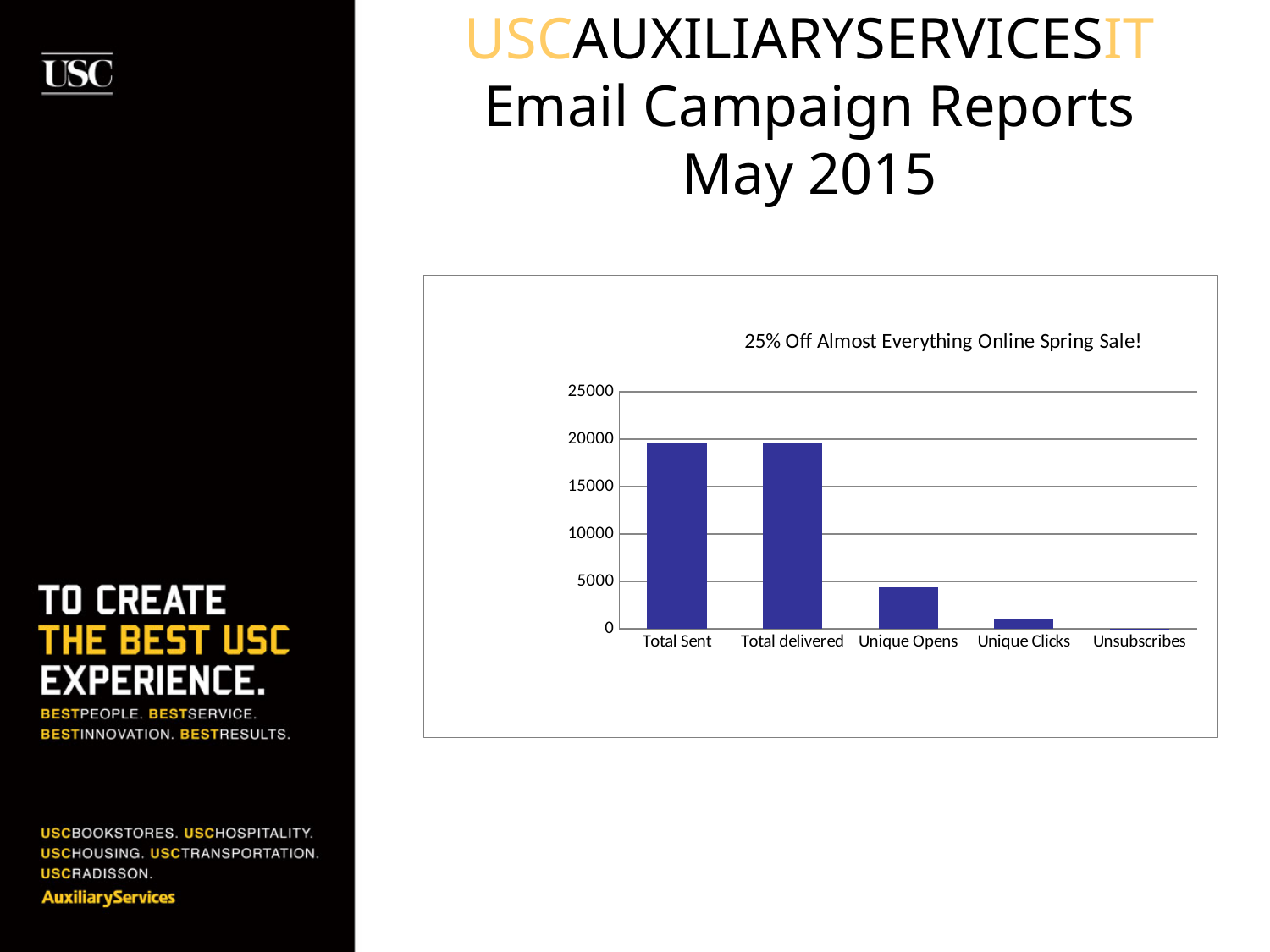
Which is larger, the value for Unique Opens or the value for Unique Clicks? Unique Opens Which is larger, the value for Total delivered or the value for Unique Opens? Total delivered What is the title of the chart? 25% Off Almost Everything Online Spring Sale! What kind of chart is shown on the slide? bar chart Is the value for Unique Clicks greater or less than 5000? less How many categories are shown on the x axis of the chart? 5 Is the value for Unique Opens greater or less than 5000? less Do the values rise or fall moving from left to right along the x axis? fall Which category has the lowest value in the chart? Unsubscribes Is the value for Total delivered greater or less than 15000? greater